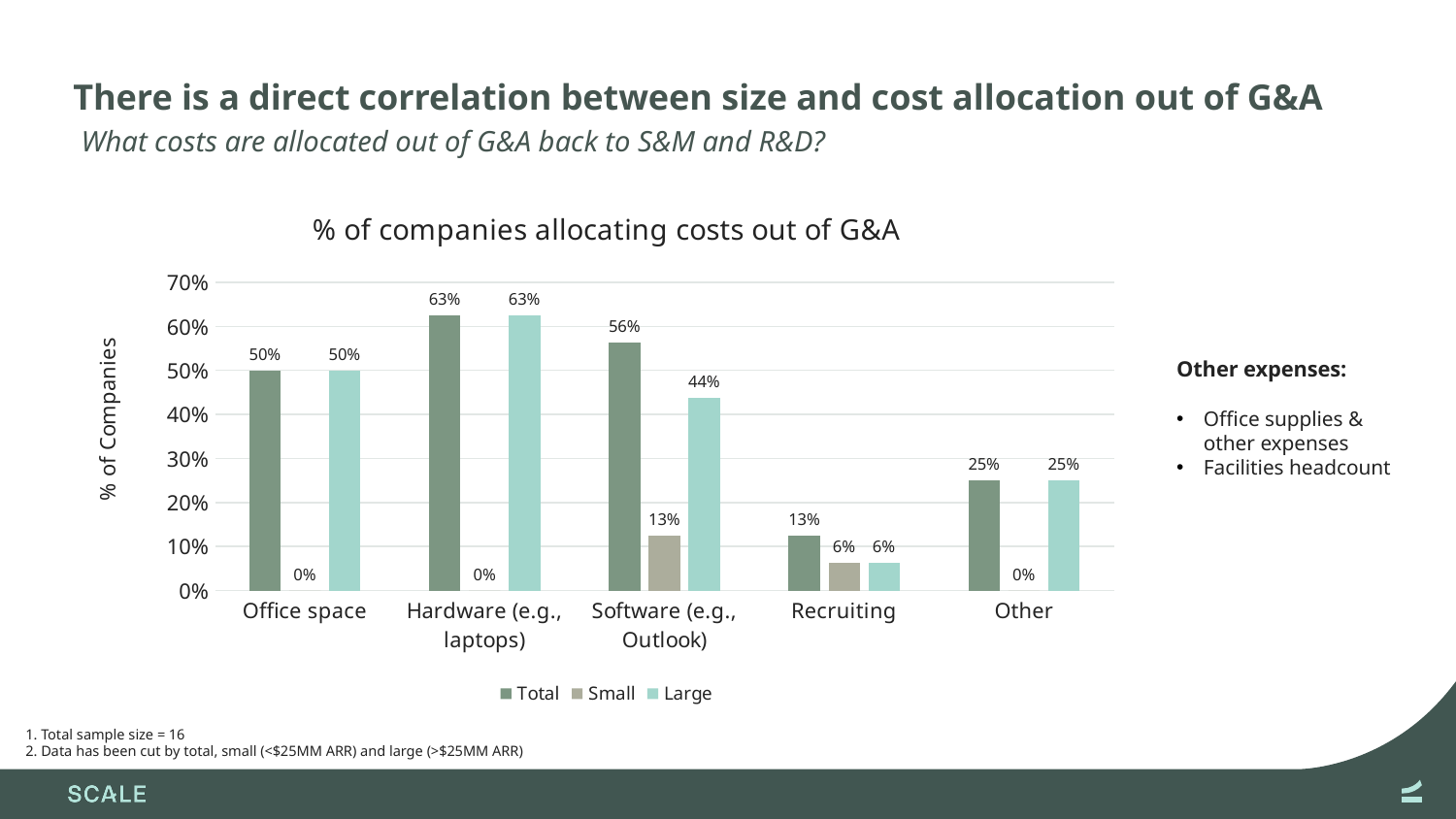
What is the title of the chart? % of companies allocating costs out of G&A Which category has the lowest Total value? Recruiting Is the Large value for Other greater or less than 30%? less Which is larger, the Small value for Software (e.g., Outlook) or the Small value for Recruiting? Software (e.g., Outlook) What is the difference between the Total and Large values for Software (e.g., Outlook)? 12% How many categories are shown on the x axis? 5 What kind of chart is shown on the slide? bar chart What is the Large value for Software (e.g., Outlook)? 44% What is the Small value for Recruiting? 6% Which category has the highest Total value? Hardware (e.g., laptops) How many series does the legend list? 3 What is the Total value for Hardware (e.g., laptops)? 63%